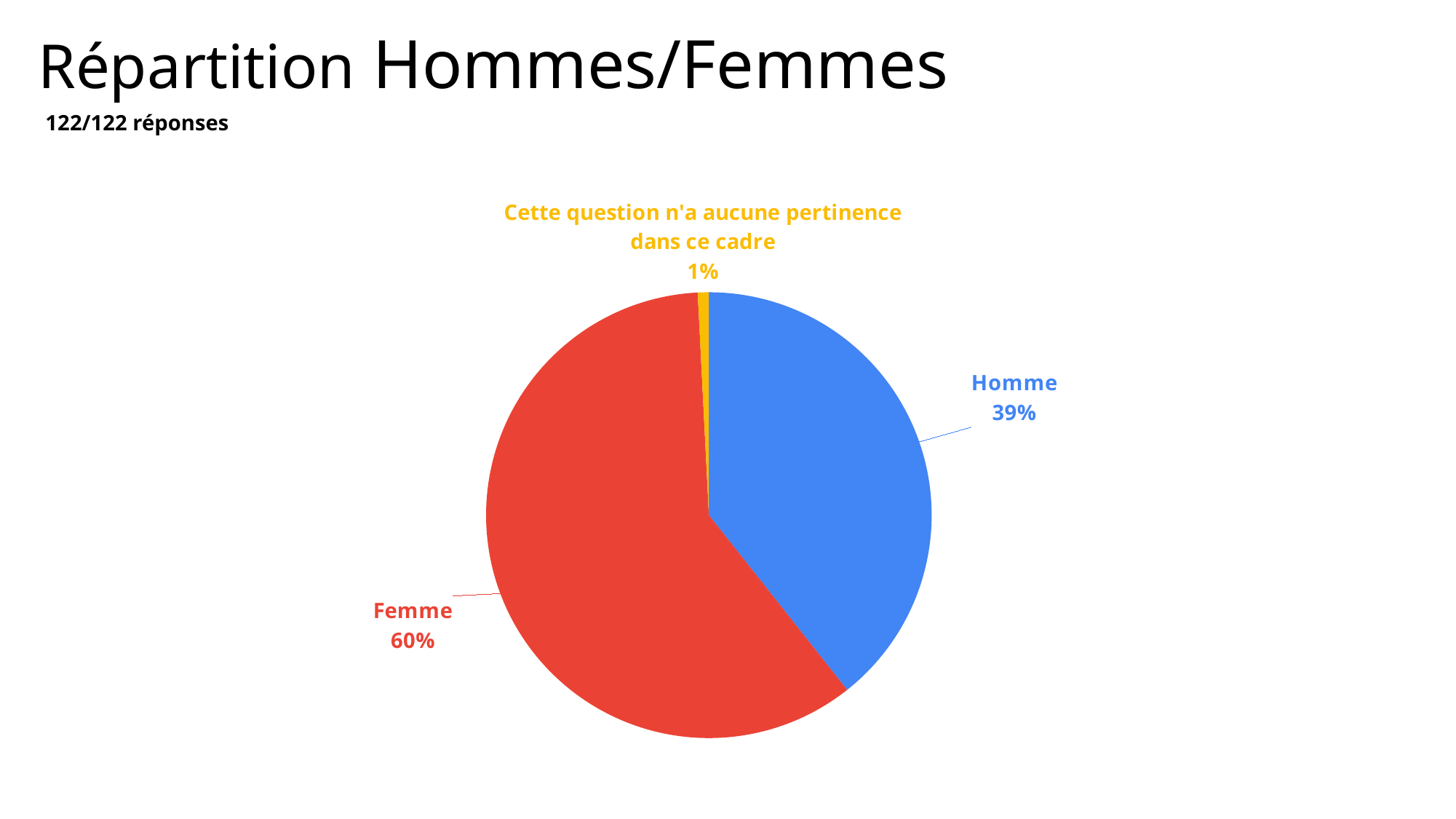
What colour is the Homme slice? Blue How many responses does the slide report? 122/122 réponses Which slice is larger, Homme or Femme? Femme Which category has the smallest slice of the pie? Cette question n'a aucune pertinence dans ce cadre What is the difference in percentage points between the Femme and Homme slices? 21 How many slices does the pie chart have? 3 Which category has the largest slice of the pie? Femme What is the title of the slide? Répartition Hommes/Femmes What share of the pie does Homme represent? 39% What share of the pie does Femme represent? 60% What share of the pie does "Cette question n'a aucune pertinence dans ce cadre" represent? 1% What kind of chart is shown on the slide? Pie chart